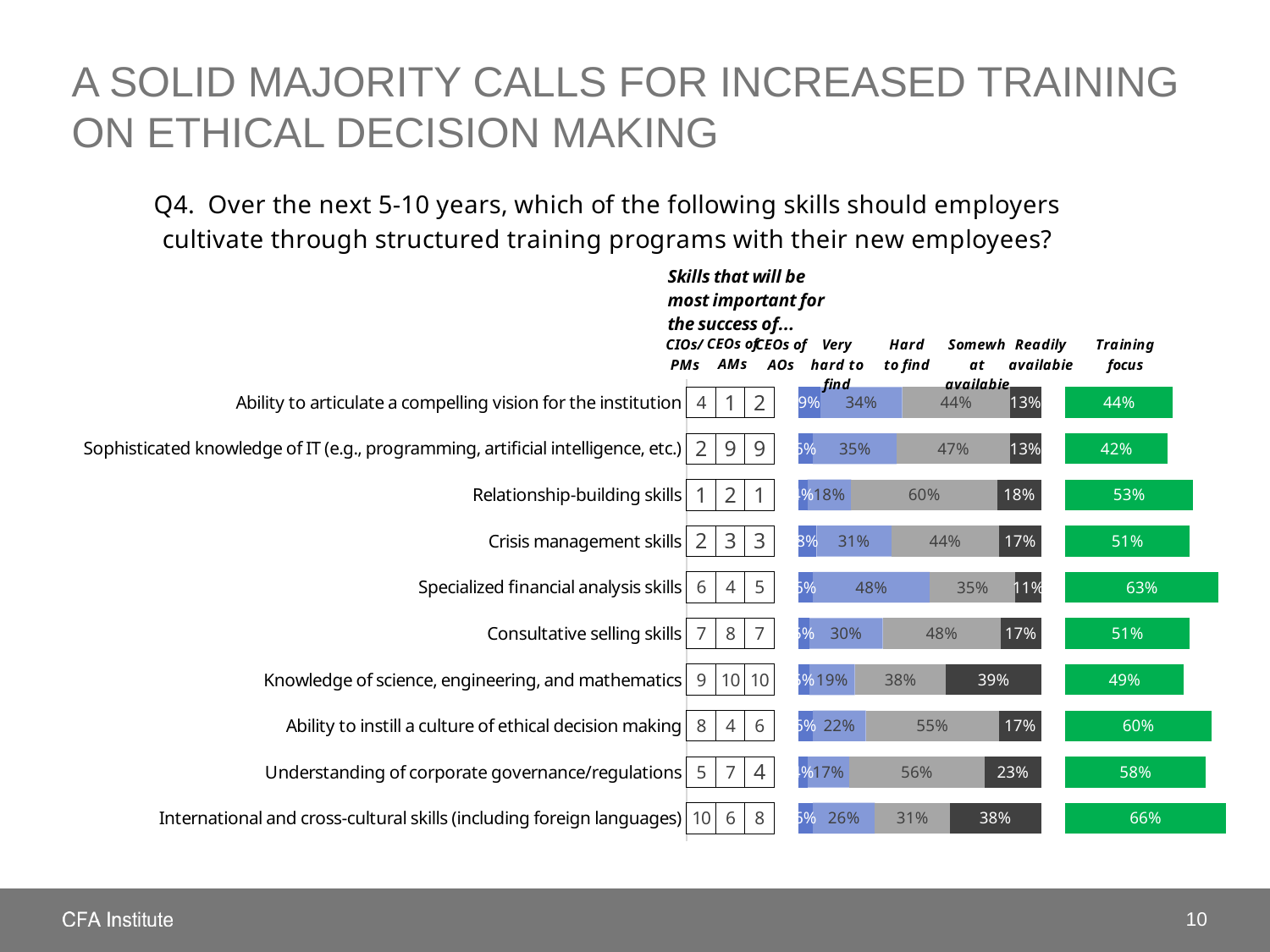
In the stacked availability chart, what is the Somewhat available value for Relationship-building skills? 60% What kind of chart is the Training focus chart? Bar chart In the stacked availability chart, what is the Hard to find value for Specialized financial analysis skills? 48% In the Training focus chart, what is the difference between the values for Ability to instill a culture of ethical decision making and Understanding of corporate governance/regulations? 2 percentage points In the Training focus chart, which skill has the highest value? International and cross-cultural skills (including foreign languages) How many availability segments (series) make up each bar in the stacked availability chart? 4 How many skills are listed as categories in the charts? 10 In the Training focus chart, what is the value for International and cross-cultural skills (including foreign languages)? 66% In the stacked availability chart, which skill has the highest Somewhat available value? Relationship-building skills In the Training focus chart, which skill has the lowest value? Sophisticated knowledge of IT (e.g., programming, artificial intelligence, etc.) In the stacked availability chart, which is larger: the Somewhat available value for Relationship-building skills or for Specialized financial analysis skills? Relationship-building skills In the stacked availability chart, what is the Readily available value for Knowledge of science, engineering, and mathematics? 39%